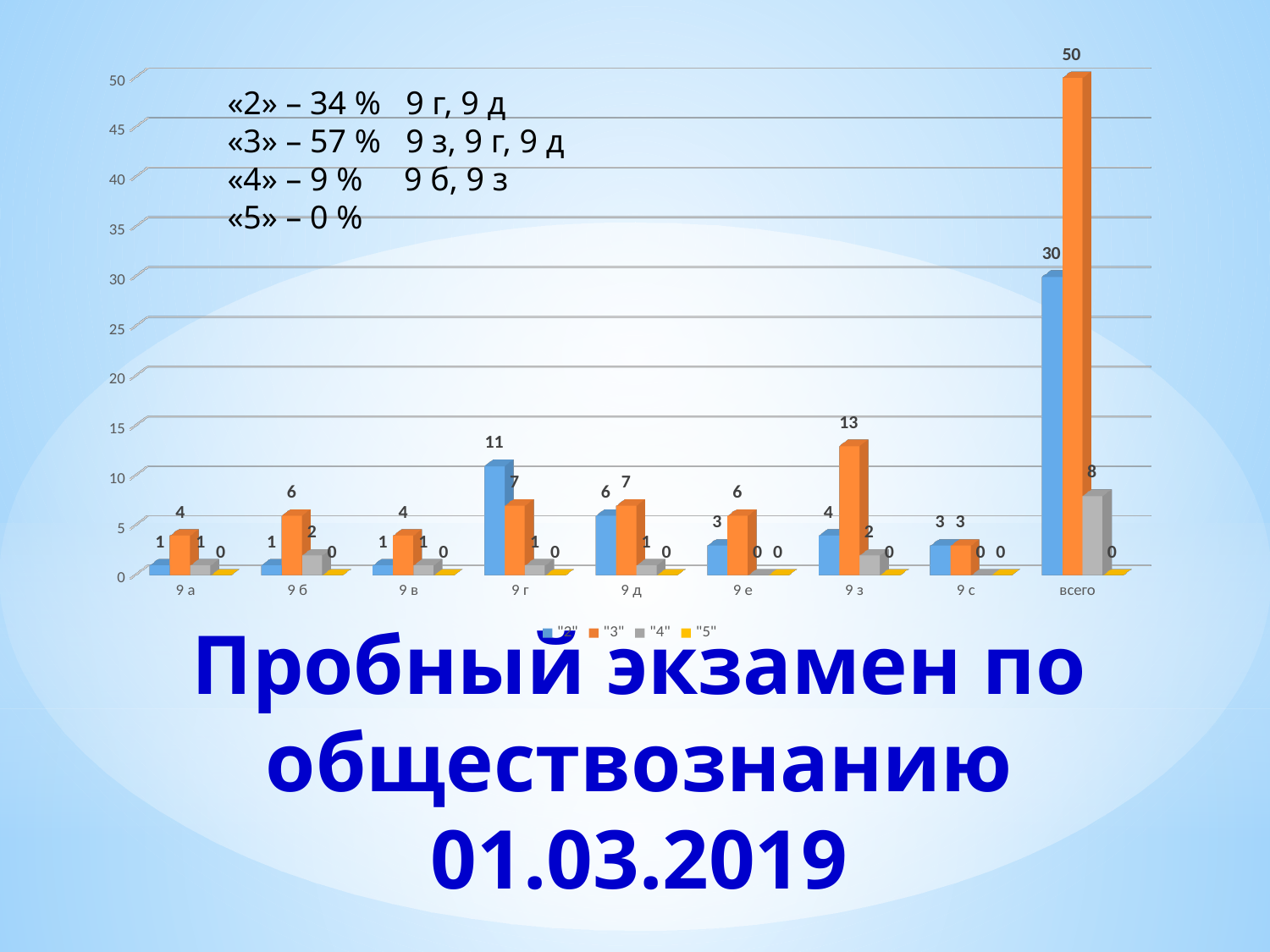
What is the value of the "5" series (yellow) for the category 9 а? 0 For the category 9 г, which is larger: the blue series value or the "3" series (orange) value? the blue series value What is the value of the "4" series (gray) for the category всего? 8 What is the value of the blue series for the category 9 г? 11 What is the value of the "3" series (orange) for the category 9 з? 13 How many series does the chart's legend list? 4 What is the difference between the "3" series values for 9 б and 9 с? 3 What is the value of the "3" series (orange) for the category всего? 50 Excluding всего, which category has the highest value in the "3" series (orange)? 9 з How many categories are shown on the x axis of the chart? 9 What is the difference between the "3" series value and the blue series value for the category всего? 20 What type of chart is shown on the slide? bar chart